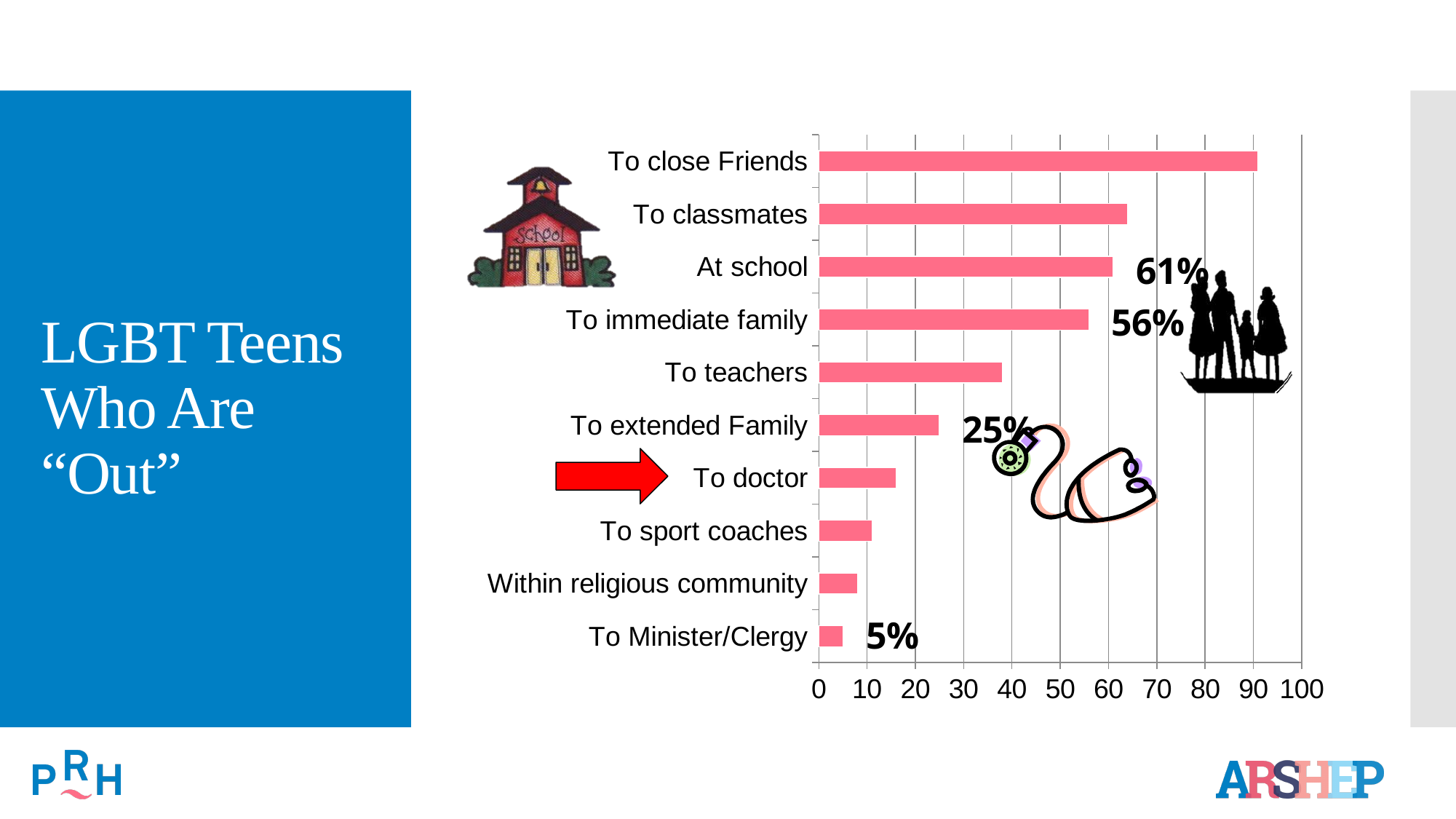
Is the value for "To doctor" greater or less than 20? less Is the value for "To close Friends" greater or less than 80? greater What is the value for "To immediate family"? 56% Which is larger, the value for "To teachers" or the value for "To doctor"? To teachers How many categories are shown in the chart? 10 What is the value for "At school"? 61% Which category has the lowest value? To Minister/Clergy What is the difference between the values for "At school" and "To immediate family"? 5 percentage points Which category has the highest value? To close Friends What is the value for "To Minister/Clergy"? 5% What is the value for "To extended Family"? 25% What kind of chart is shown on the slide? bar chart